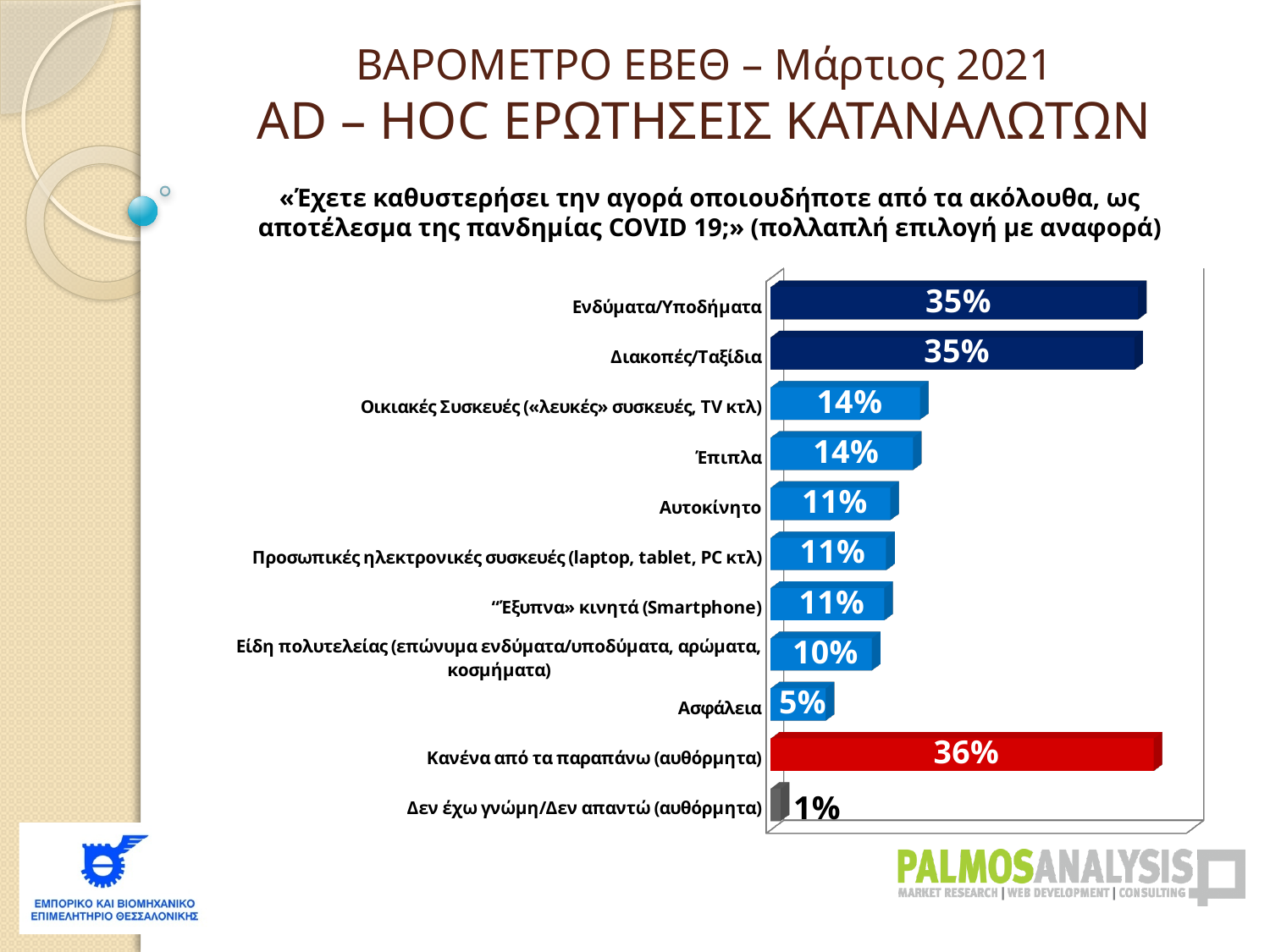
What percentage is shown for Είδη πολυτελείας (επώνυμα ενδύματα/υποδύματα, αρώματα, κοσμήματα)? 10% What colour is the bar for Κανένα από τα παραπάνω (αυθόρμητα)? Red Which is larger, the value for Ασφάλεια or the value for Είδη πολυτελείας? Είδη πολυτελείας Which category has the highest value? Κανένα από τα παραπάνω (αυθόρμητα) What is the difference in percentage points between Διακοπές/Ταξίδια and Έπιπλα? 21 What kind of chart is shown on the slide? Bar chart Which category has the lowest value? Δεν έχω γνώμη/Δεν απαντώ (αυθόρμητα) What percentage is shown for Ενδύματα/Υποδήματα? 35% What is the value for Ασφάλεια? 5% How many categories are shown in the chart? 11 What is the value for Αυτοκίνητο? 11% What is the difference in percentage points between Κανένα από τα παραπάνω (αυθόρμητα) and Ενδύματα/Υποδήματα? 1